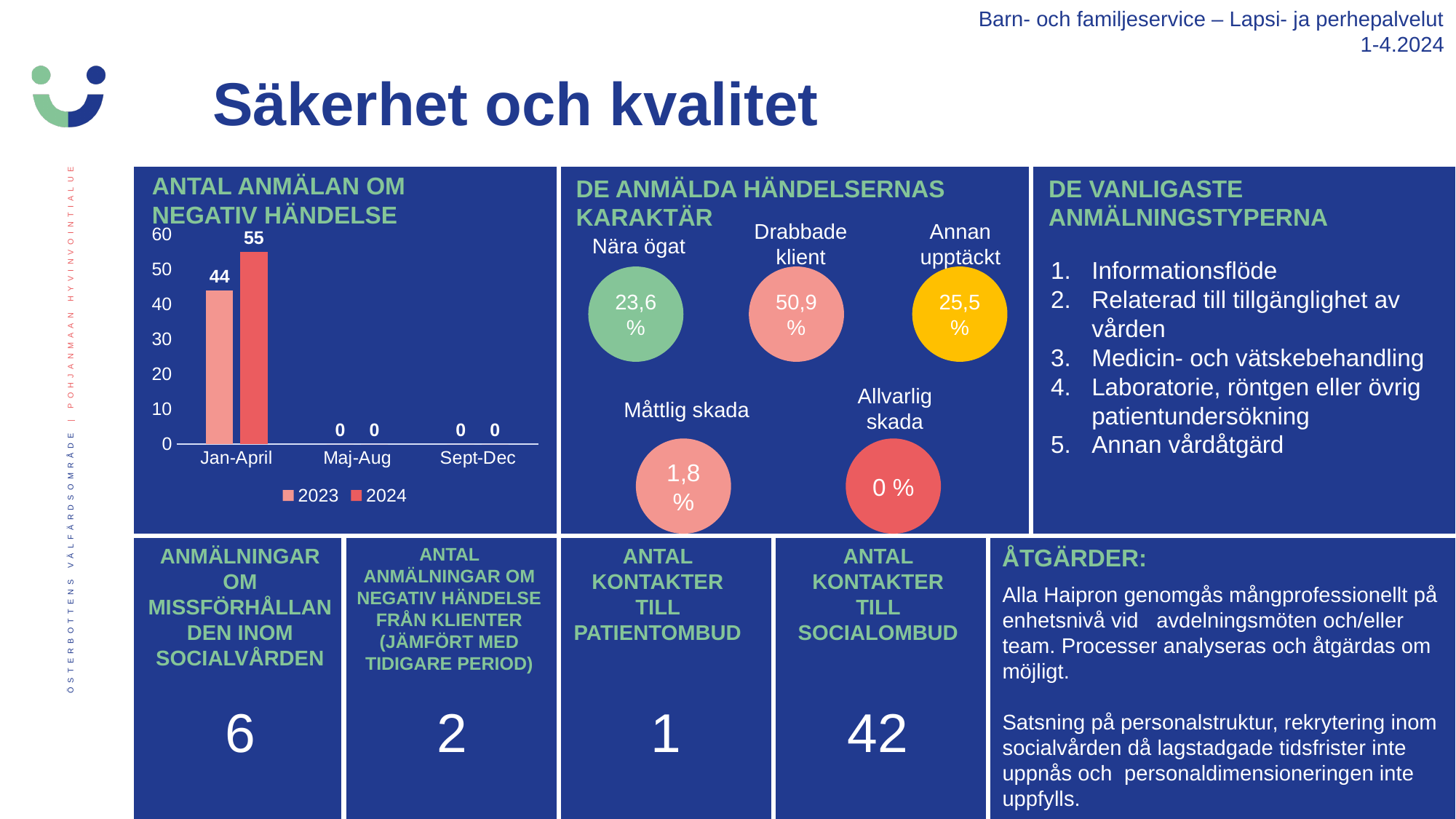
Is the 2023 value for Jan-April greater or less than 40? greater What is the value for 2024 in the Maj-Aug category of the bar chart? 0 How many series does the legend of the bar chart list? 2 What is the title of the bar chart on the slide? ANTAL ANMÄLAN OM NEGATIV HÄNDELSE How many categories are shown on the x axis of the bar chart? 3 In the Jan-April category, which series has the larger value, 2023 or 2024? 2024 What is the value for 2023 in the Sept-Dec category of the bar chart? 0 What is the value for 2024 in the Jan-April category of the bar chart? 55 What is the difference between the 2024 and 2023 values for Jan-April in the bar chart? 11 Which category has the highest value for the 2024 series in the bar chart? Jan-April What kind of chart is used for 'ANTAL ANMÄLAN OM NEGATIV HÄNDELSE'? bar chart What is the value for 2023 in the Jan-April category of the bar chart? 44